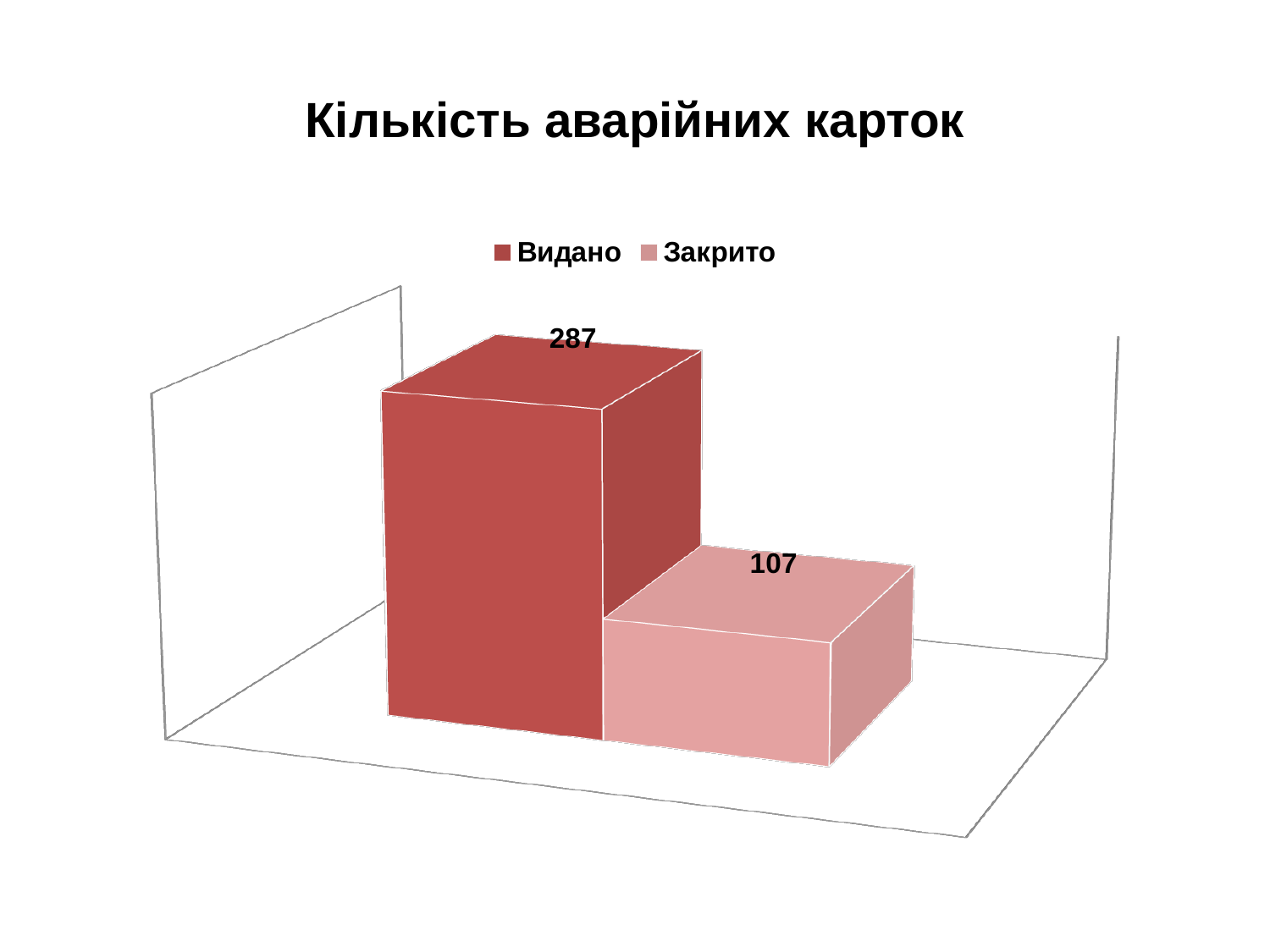
Which series is shown in the darker red colour? Видано How many series does the legend list? 2 Which series has the lowest value? Закрито What is the total of the two plotted values? 394 Which is larger, the value for Видано or the value for Закрито? Видано What kind of chart is shown on the slide? bar chart What is the difference between the values for Видано and Закрито? 180 What is the value for Видано? 287 What is the value for Закрито? 107 What is the title of the chart? Кількість аварійних карток How many bars are plotted on the chart? 2 Which series has the highest value? Видано